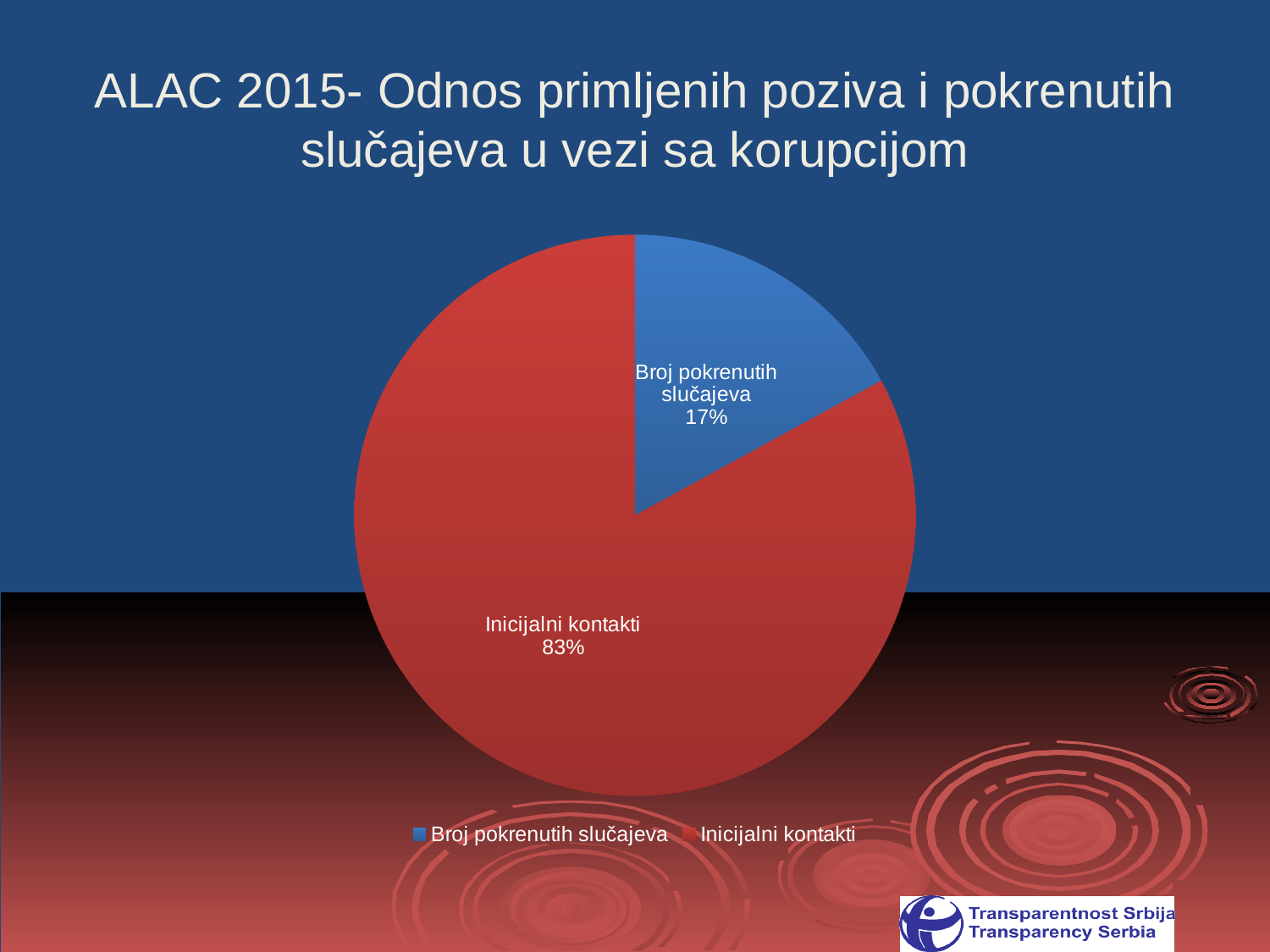
What is the difference in percentage points between "Inicijalni kontakti" and "Broj pokrenutih slučajeva"? 66 What share of the pie does "Inicijalni kontakti" represent? 83% What share of the pie does "Broj pokrenutih slučajeva" represent? 17% Which slice is the largest? Inicijalni kontakti How many entries does the legend list? 2 What kind of chart is shown on the slide? pie chart How many slices does the pie chart have? 2 Which slice is the smallest? Broj pokrenutih slučajeva Which is larger, "Broj pokrenutih slučajeva" or "Inicijalni kontakti"? Inicijalni kontakti What is the title of the chart slide? ALAC 2015- Odnos primljenih poziva i pokrenutih slučajeva u vezi sa korupcijom What colour is the "Inicijalni kontakti" slice? red